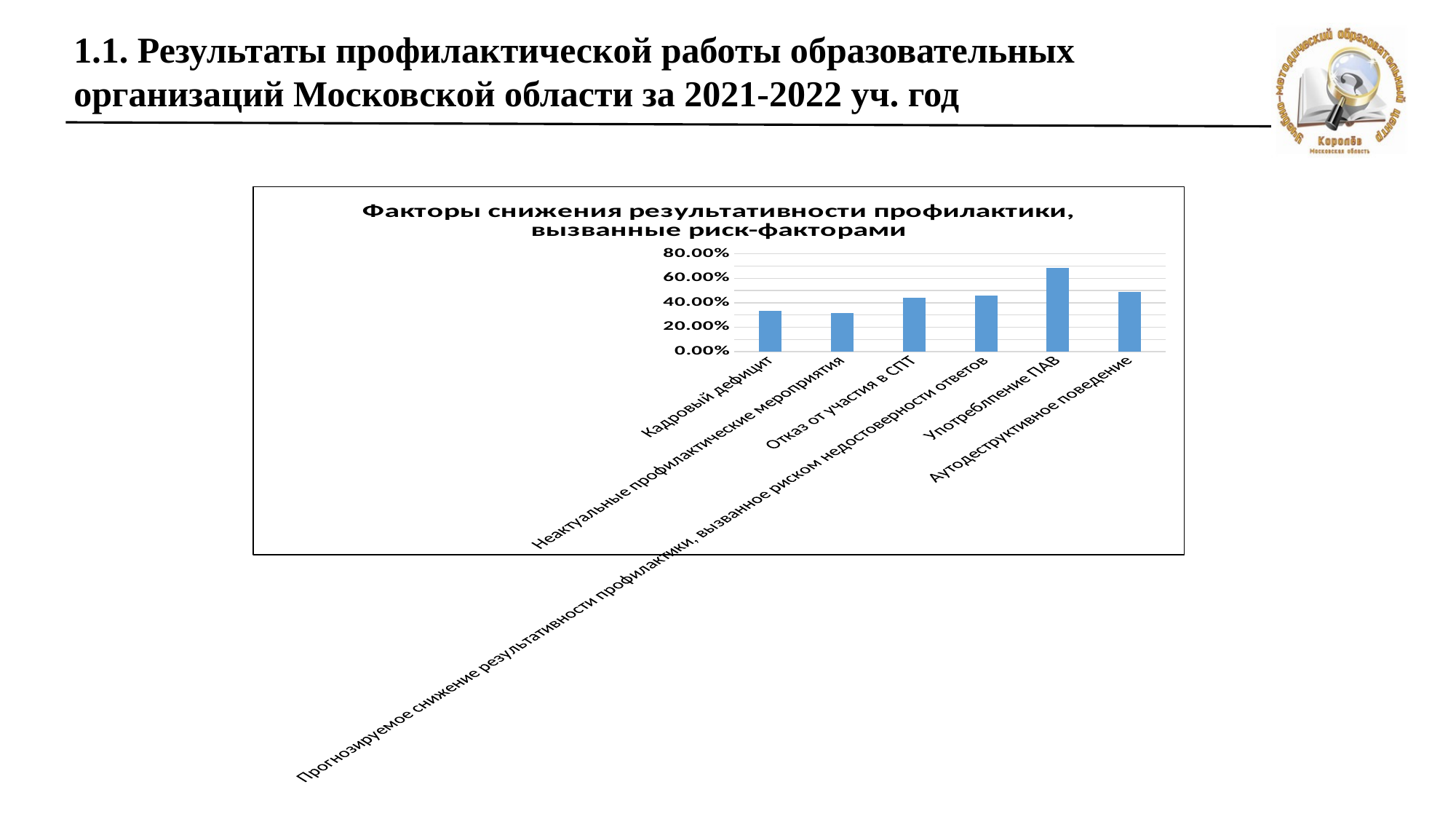
Which is larger, the value for Аутодеструктивное поведение or the value for Неактуальные профилактические мероприятия? Аутодеструктивное поведение What is the title of the chart? Факторы снижения результативности профилактики, вызванные риск-факторами Is the value for Аутодеструктивное поведение greater or less than 60.00%? less Is the value for Кадровый дефицит greater or less than 40.00%? less Is the value for Неактуальные профилактические мероприятия greater or less than 40.00%? less Which is larger, the value for Употребление ПАВ or the value for Кадровый дефицит? Употребление ПАВ What kind of chart is shown on the slide? bar chart What is the highest value shown on the vertical axis of the chart? 80.00% How many categories are plotted in the chart? 6 Which category has the highest value in the chart? Употреблпение ПАВ